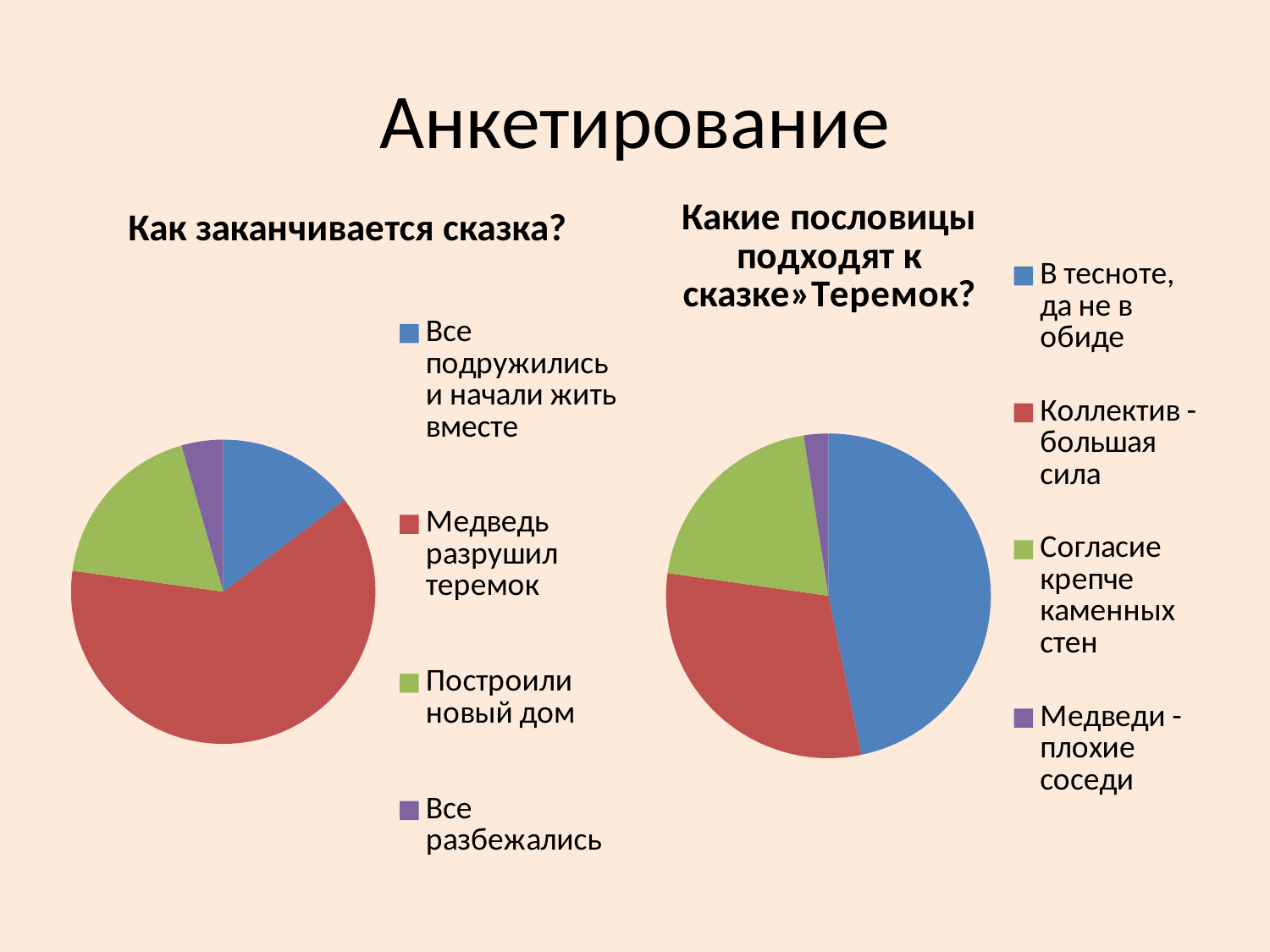
How many slices does the chart "Как заканчивается сказка?" have? 4 In the chart "Какие пословицы подходят к сказке»Теремок?", which category has the largest slice? В тесноте, да не в обиде How many slices does the chart "Какие пословицы подходят к сказке»Теремок?" have? 4 In the chart "Какие пословицы подходят к сказке»Теремок?", which slice is larger: "Коллектив - большая сила" or "Согласие крепче каменных стен"? Коллектив - большая сила In the chart "Как заканчивается сказка?", which category has the largest slice? Медведь разрушил теремок In the chart "Как заканчивается сказка?", which slice is larger: "Все подружились и начали жить вместе" or "Медведь разрушил теремок"? Медведь разрушил теремок What kind of chart is the chart titled "Какие пословицы подходят к сказке»Теремок?"? pie chart In the chart "Какие пословицы подходят к сказке»Теремок?", which category has the smallest slice? Медведи - плохие соседи In the chart "Как заканчивается сказка?", which category has the smallest slice? Все разбежались In the chart "Как заканчивается сказка?", what colour is the slice for "Построили новый дом"? green What is the title of the pie chart on the left side of the slide? Как заканчивается сказка? What kind of chart is the chart titled "Как заканчивается сказка?"? pie chart